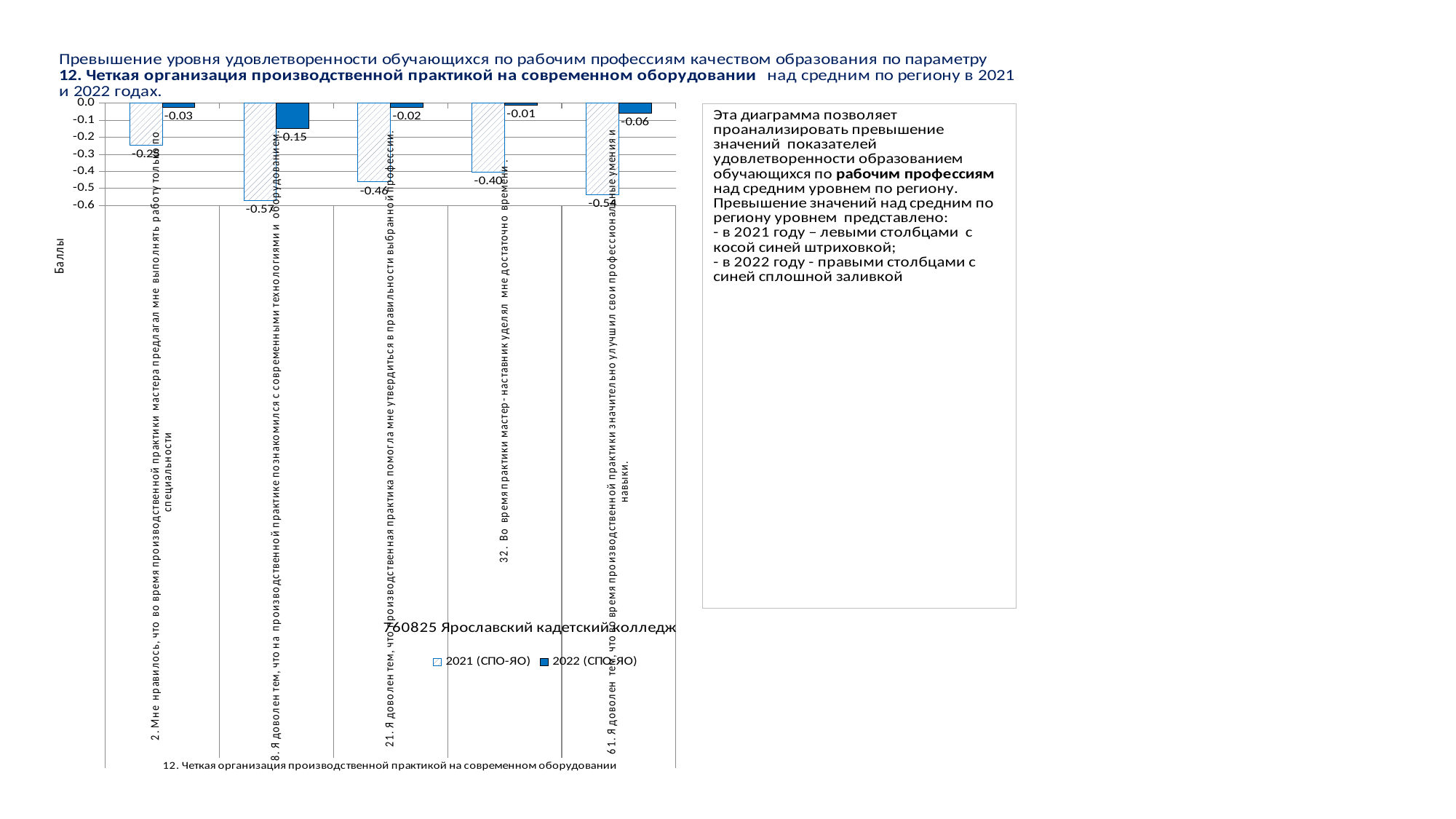
How many categories are plotted on the x axis of the chart? 5 What is the 2022 (СПО-ЯО) value for category 32 (Во время практики мастер-наставник уделял мне достаточно времени)? -0.01 What is the label of the vertical axis of the chart? Баллы Which category has the lowest 2021 (СПО-ЯО) value? 8. Я доволен тем, что на производственной практике познакомился с современными технологиями и оборудованием What is the 2021 (СПО-ЯО) value for category 61 (Я доволен тем, что во время производственной практики значительно улучшил свои профессиональные умения и навыки)? -0.54 How many series does the chart legend list? 2 What is the difference between the 2021 (СПО-ЯО) and 2022 (СПО-ЯО) values for category 8? 0.42 What is the 2022 (СПО-ЯО) value for category 21 (Я доволен тем, что производственная практика помогла мне утвердиться в правильности выбранной профессии)? -0.02 Which is larger for category 21: the 2021 (СПО-ЯО) value or the 2022 (СПО-ЯО) value? 2022 (СПО-ЯО) What is the 2021 (СПО-ЯО) value for category 8 (Я доволен тем, что на производственной практике познакомился с современными технологиями и оборудованием)? -0.57 Which category has the lowest 2022 (СПО-ЯО) value? 8. Я доволен тем, что на производственной практике познакомился с современными технологиями и оборудованием What kind of chart is shown on the slide? bar chart